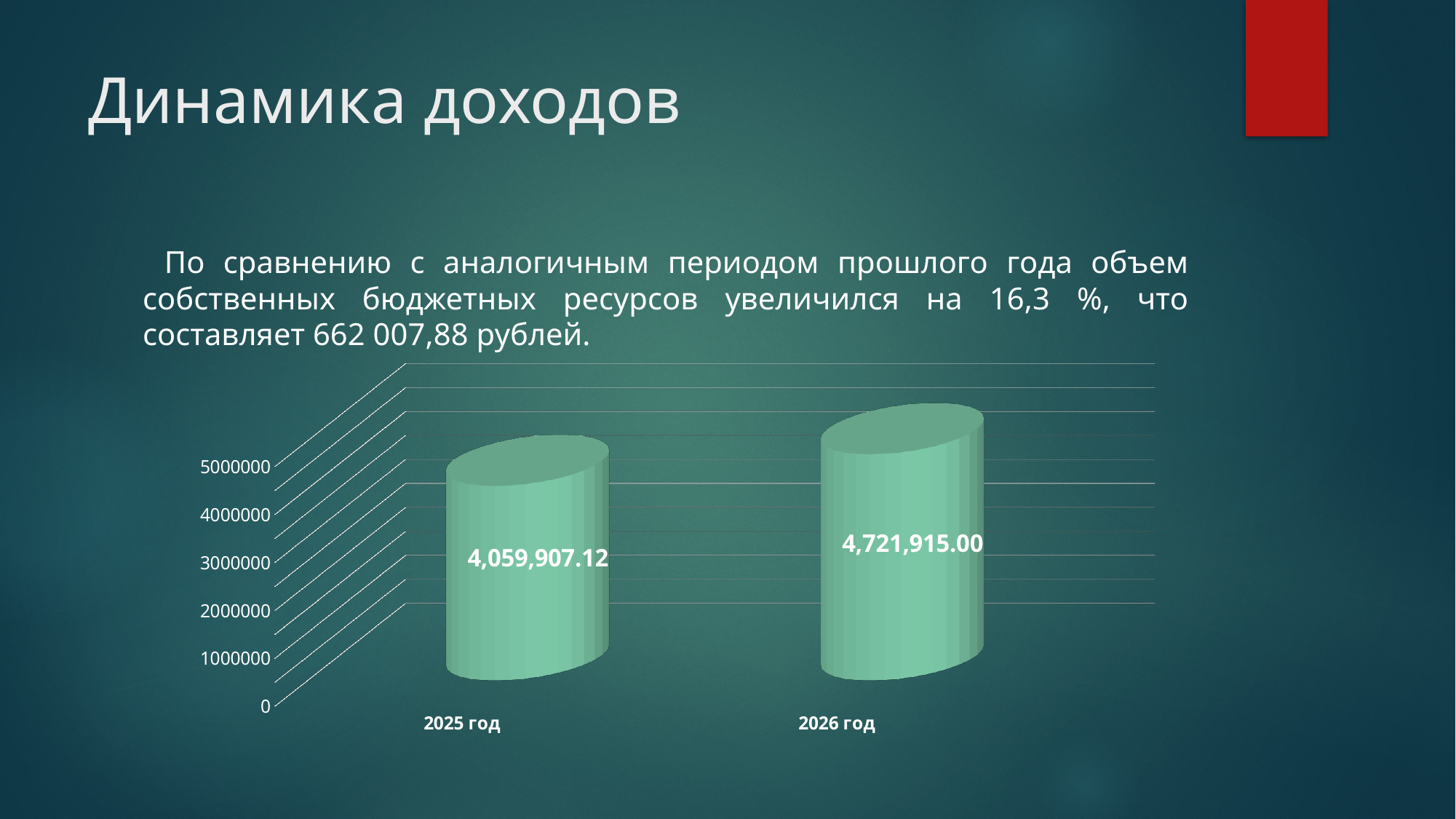
How many categories are shown on the chart? 2 What kind of chart is shown on the slide? bar chart Do the values rise or fall from 2025 год to 2026 год? rise Is the value for 2026 год greater or less than 5000000? less What is the difference between the values for 2026 год and 2025 год? 662,007.88 Which category has the lowest value? 2025 год What is the value shown for 2026 год? 4,721,915.00 Which category has the highest value? 2026 год What is the title of the slide containing the chart? Динамика доходов Is the value for 2025 год greater or less than 4000000? greater Which is larger, the value for 2025 год or the value for 2026 год? 2026 год What is the value shown for 2025 год? 4,059,907.12